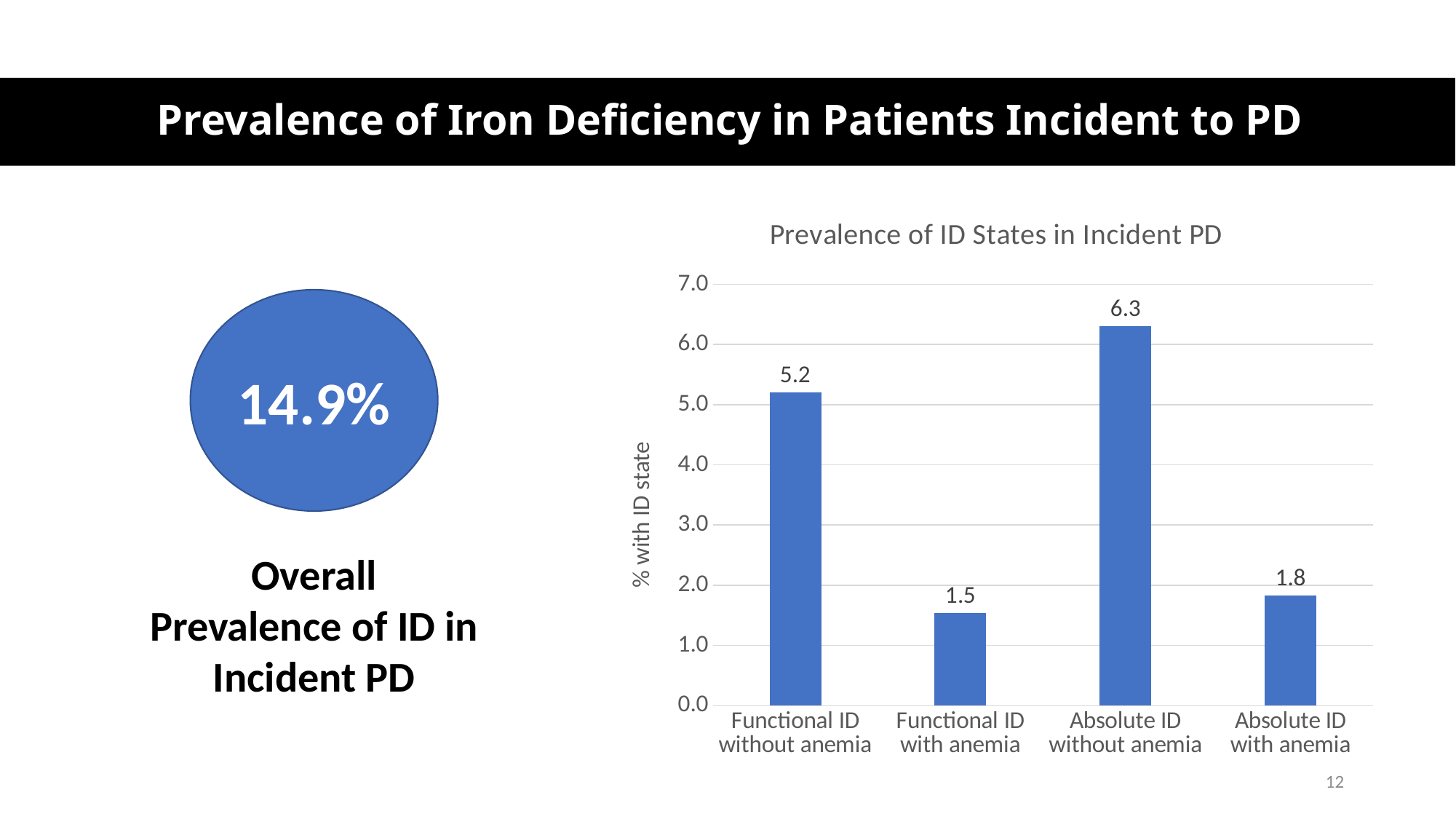
What is the title of the chart? Prevalence of ID States in Incident PD Which is larger: Absolute ID with anemia or Functional ID with anemia? Absolute ID with anemia What kind of chart is shown? bar chart What is the value for Functional ID with anemia? 1.5 What is the value for Absolute ID with anemia? 1.8 Which category has the highest value? Absolute ID without anemia What is the label of the y axis? % with ID state How many categories are shown on the x axis? 4 What is the difference between Absolute ID without anemia and Functional ID without anemia? 1.1 Which category has the lowest value? Functional ID with anemia What is the value for Functional ID without anemia? 5.2 Is the value for Absolute ID without anemia greater or less than 6.0? greater